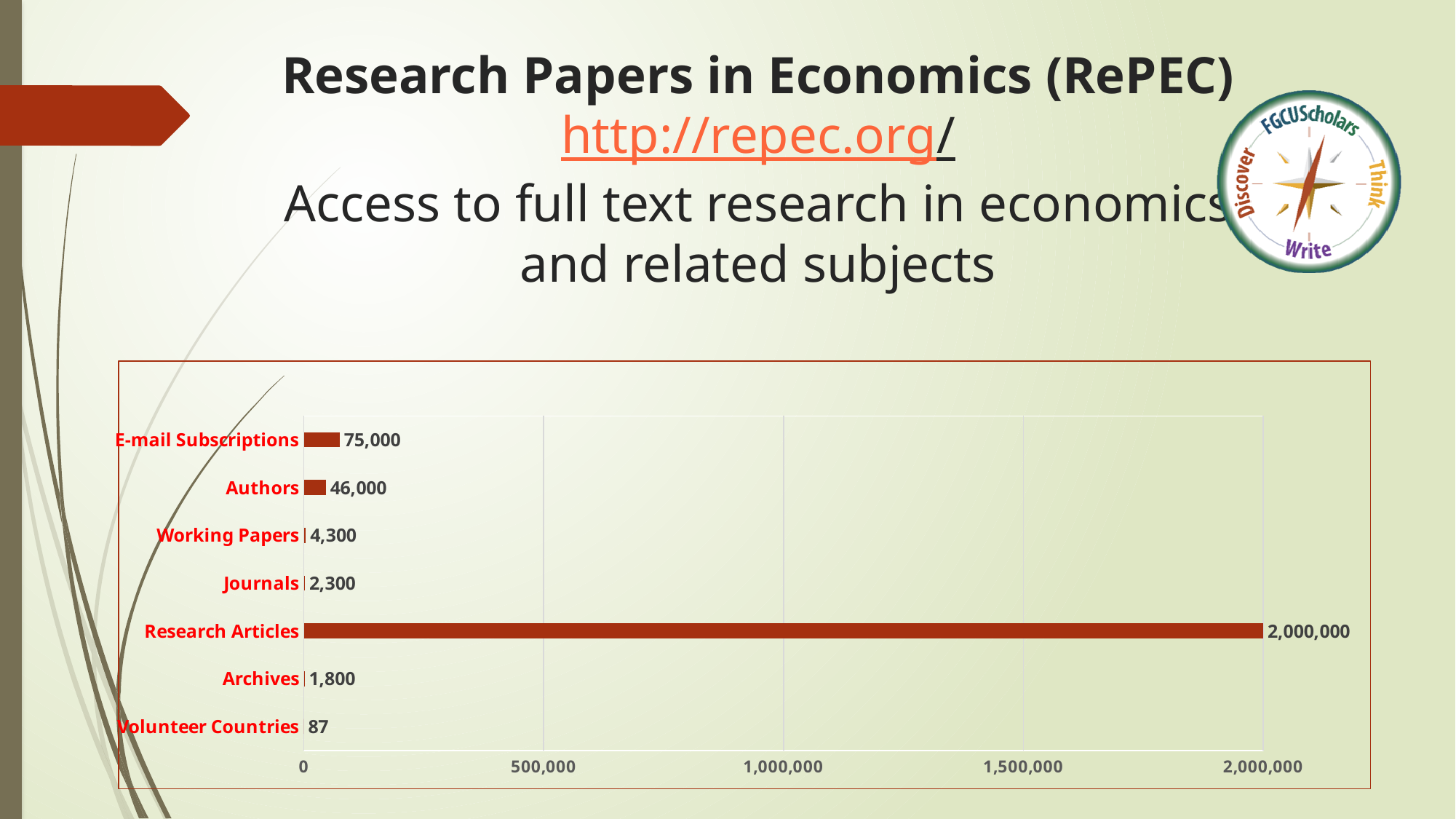
Which category has the lowest value? Volunteer Countries Is the value for Research Articles greater or less than 1,500,000? greater What is the difference between the values for Working Papers and Journals? 2,000 Which is larger, the value for Journals or the value for Archives? Journals What is the value for Research Articles? 2,000,000 What kind of chart is shown on the slide? bar chart What is the value for Volunteer Countries? 87 What is the value for Authors? 46,000 How many categories are shown in the chart? 7 Which category has the highest value? Research Articles What is the value for E-mail Subscriptions? 75,000 What is the difference between the values for E-mail Subscriptions and Authors? 29,000